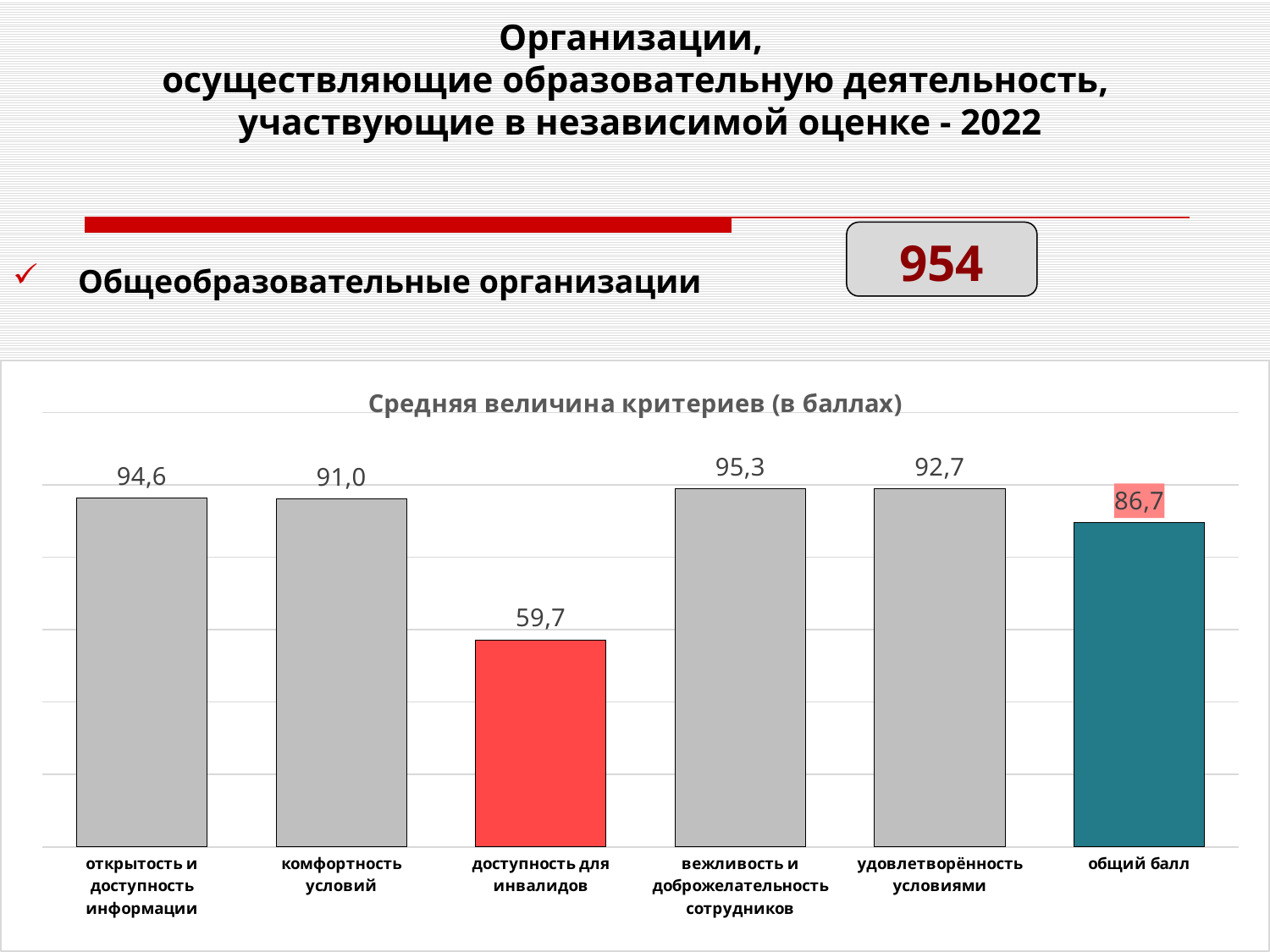
What is the title of the chart? Средняя величина критериев (в баллах) What is the difference between "вежливость и доброжелательность сотрудников" and "доступность для инвалидов"? 35,6 What is the difference between "удовлетворённость условиями" and "общий балл"? 6,0 What is the value for "доступность для инвалидов"? 59,7 Which is larger: "открытость и доступность информации" or "комфортность условий"? открытость и доступность информации Which category has the highest value? вежливость и доброжелательность сотрудников What is the value for "общий балл"? 86,7 What is the value for "комфортность условий"? 91,0 What kind of chart is shown on the slide? bar chart What is the value for "вежливость и доброжелательность сотрудников"? 95,3 Which category has the lowest value? доступность для инвалидов How many bars are shown in the chart? 6